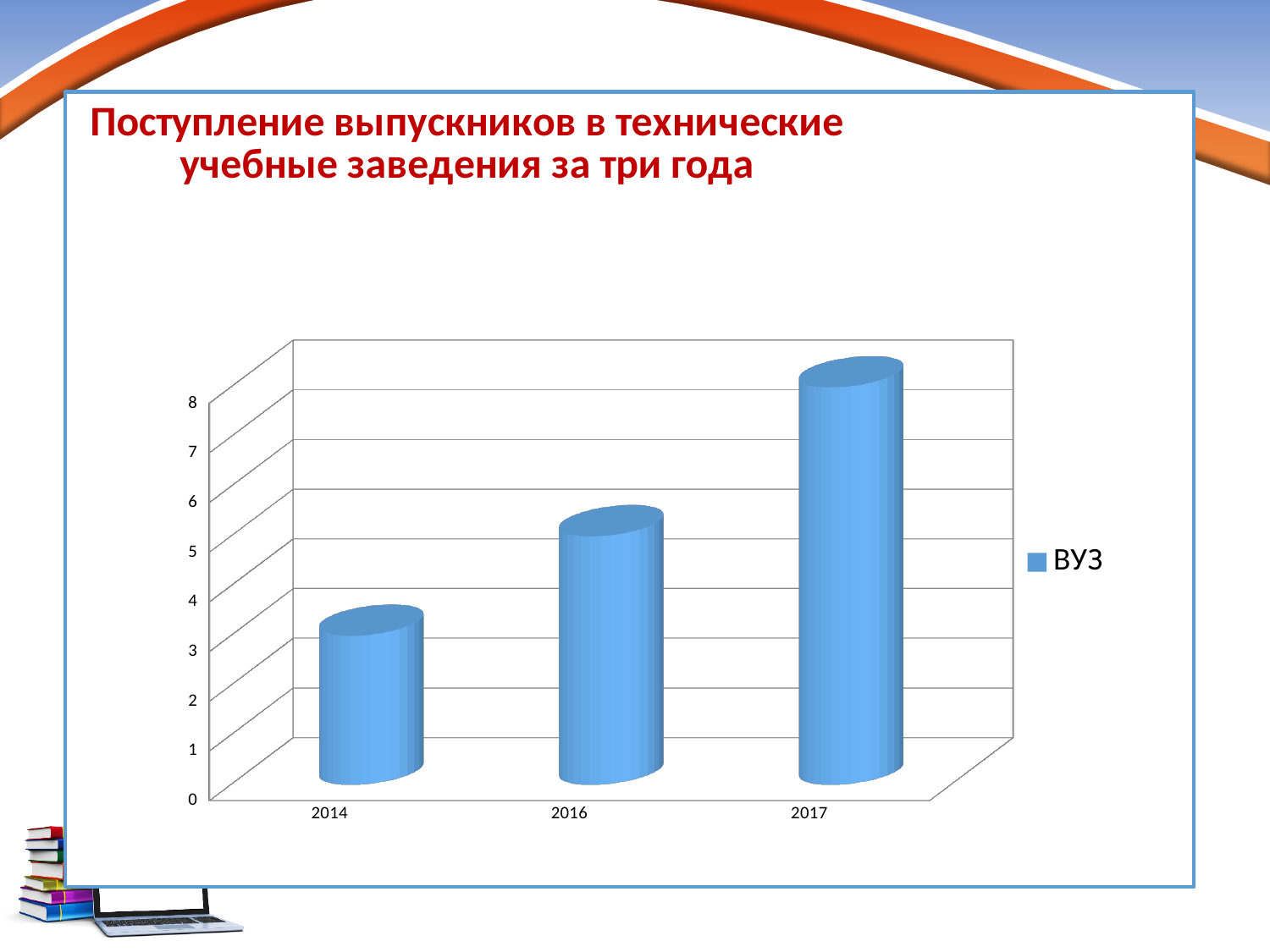
How many categories (years) are shown on the x axis? 3 Is the value for 2014 greater or less than 4? less Which is larger, the value for 2016 or the value for 2014? 2016 How many series does the legend list? 1 What is the title of the slide? Поступление выпускников в технические учебные заведения за три года Is the value for 2016 greater or less than 4? greater Is the value for 2017 greater or less than 6? greater Do the values rise or fall from 2014 to 2017? rise Which year has the highest value? 2017 What is the name of the series shown in the legend? ВУЗ Which year has the lowest value? 2014 What kind of chart is shown on the slide? bar chart